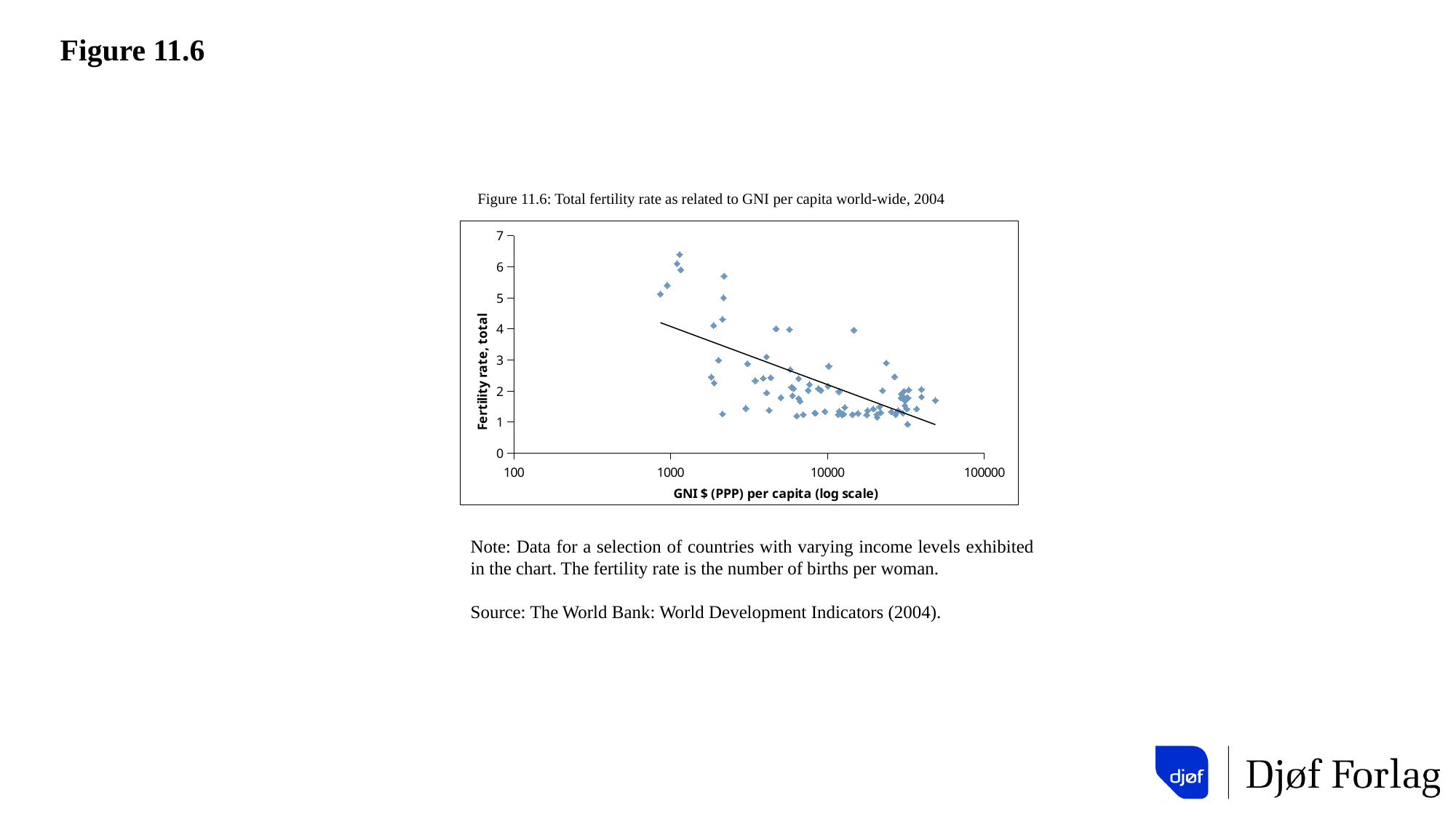
Is the fertility rate of the point with the highest GNI per capita greater or less than 2? less As GNI per capita increases along the x axis, does the fertility rate generally rise or fall? fall What is the label of the y axis? Fertility rate, total Is the highest fertility rate plotted greater or less than 6? greater What kind of chart is shown on the slide? scatter chart What is the label of the x axis? GNI $ (PPP) per capita (log scale) Is the lowest fertility rate plotted greater or less than 2? less Does the fitted trend line slope upward or downward from left to right? downward